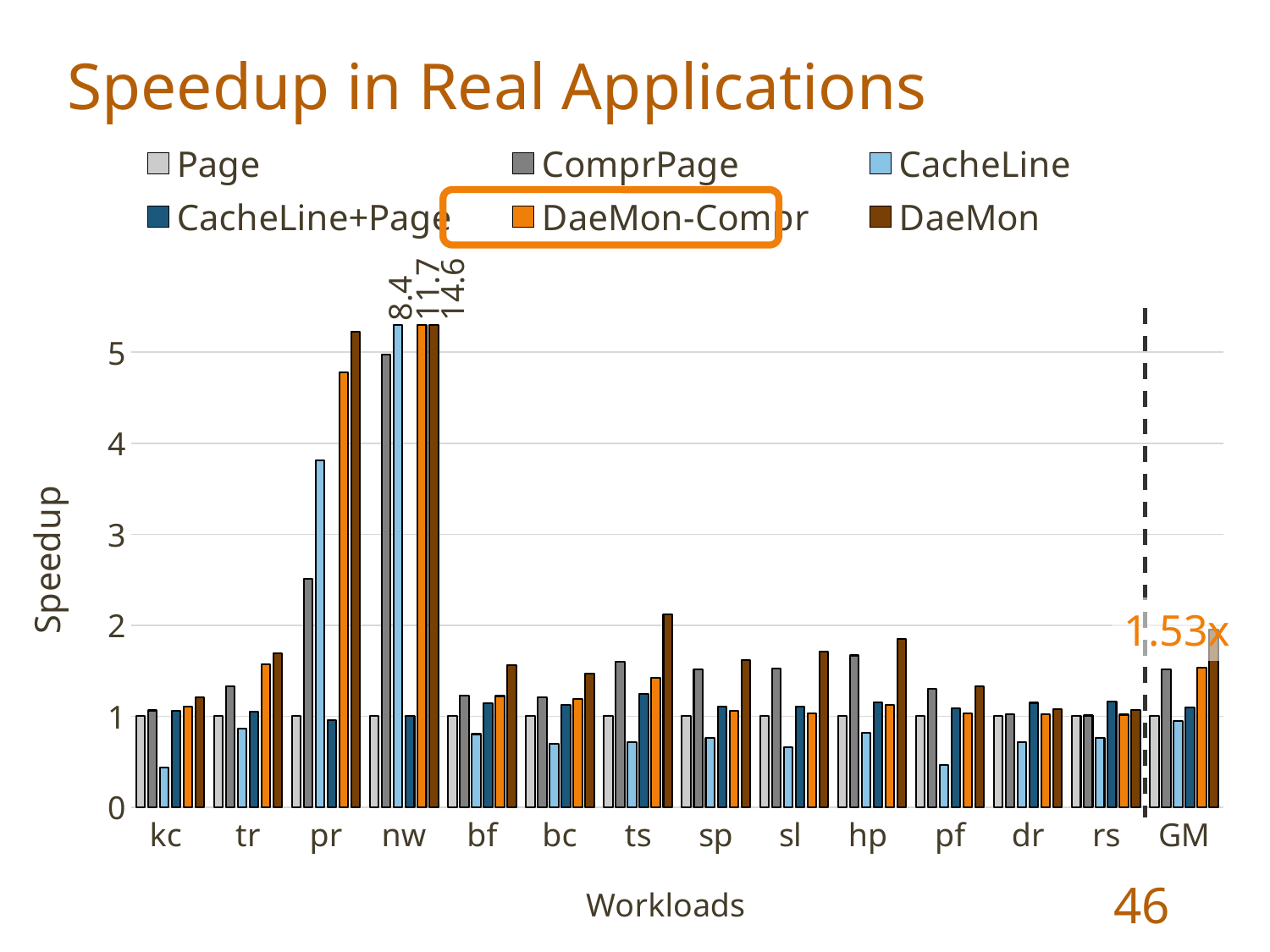
How many series does the legend list? 6 What is the speedup of DaeMon-Compr for the nw workload? 11.7 For the nw workload, how much higher is the DaeMon speedup than the DaeMon-Compr speedup? 2.9 Which workload has the highest DaeMon speedup? nw What is the speedup of DaeMon for the nw workload? 14.6 Is the CacheLine speedup for the pr workload greater or less than 3? greater For the pr workload, which is larger: the ComprPage speedup or the CacheLine speedup? CacheLine Which legend entry is highlighted with an orange box? DaeMon-Compr What is the speedup of CacheLine for the nw workload? 8.4 Is the CacheLine speedup for the kc workload greater or less than 1? less What kind of chart is shown on the slide? bar chart How many workloads are shown along the x axis? 14